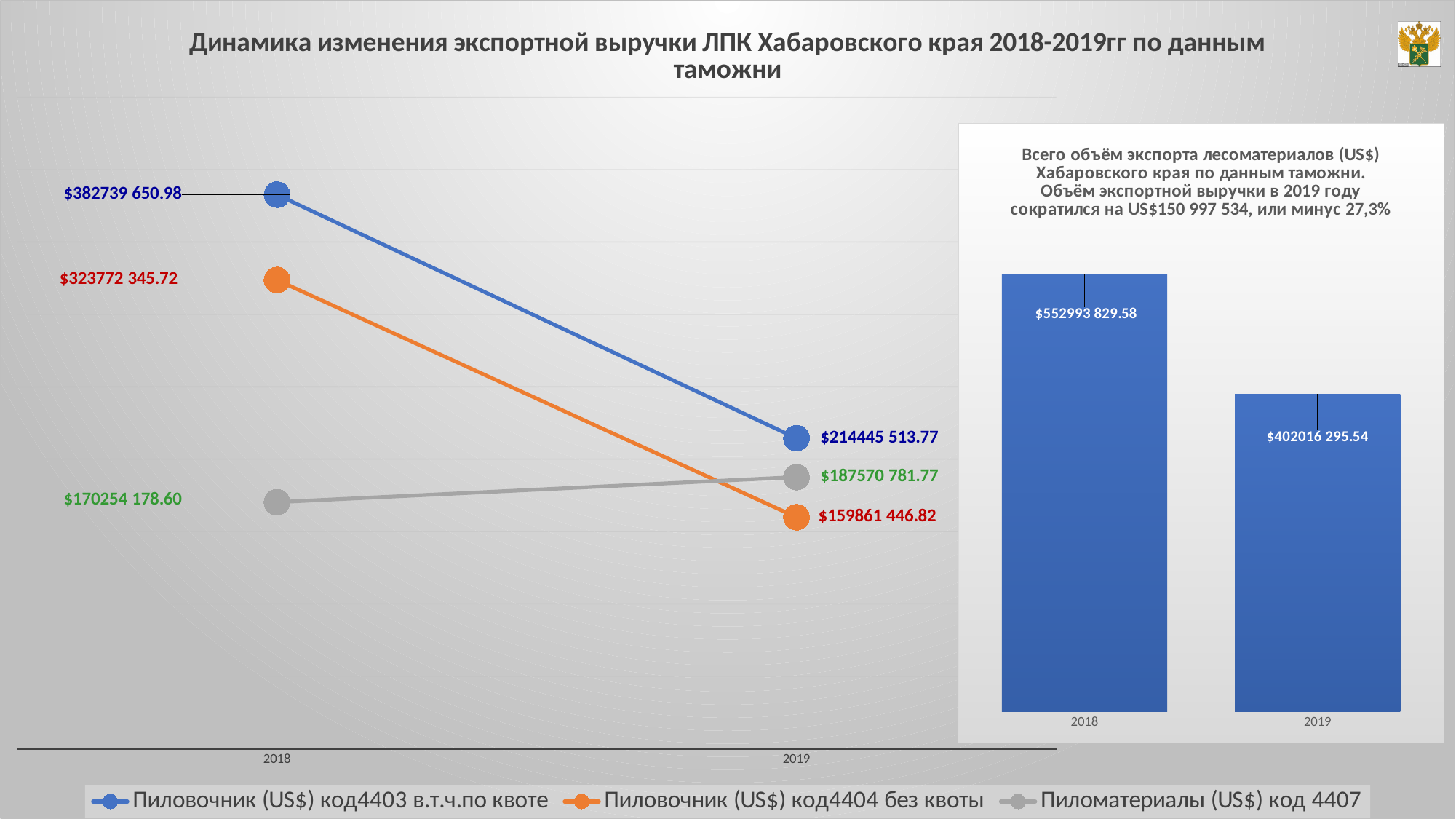
On the left line chart, does the Пиловочник (US$) код4403 в т.ч. по квоте series rise or fall from 2018 to 2019? fall On the left line chart, what is the difference between the 2019 and 2018 values for Пиломатериалы (US$) код 4407? $17316 603.17 On the right bar chart, which year has the higher value? 2018 On the left line chart, what is the 2019 value for Пиломатериалы (US$) код 4407? $187570 781.77 How many series does the legend of the left line chart list? 3 On the left line chart, is the 2019 value for Пиломатериалы (US$) код 4407 larger or smaller than its 2018 value? larger On the left line chart, which series has the lowest value in 2019? Пиловочник (US$) код4404 без квоты On the left line chart, what is the 2018 value for Пиловочник (US$) код4403 в т.ч. по квоте? $382739 650.98 On the left line chart, what is the 2019 value for Пиловочник (US$) код4404 без квоты? $159861 446.82 What kind of chart is shown on the right side of the slide? bar chart On the left line chart, which series has the highest value in 2018? Пиловочник (US$) код4403 в т.ч. по квоте On the right bar chart, what is the value for 2019? $402016 295.54